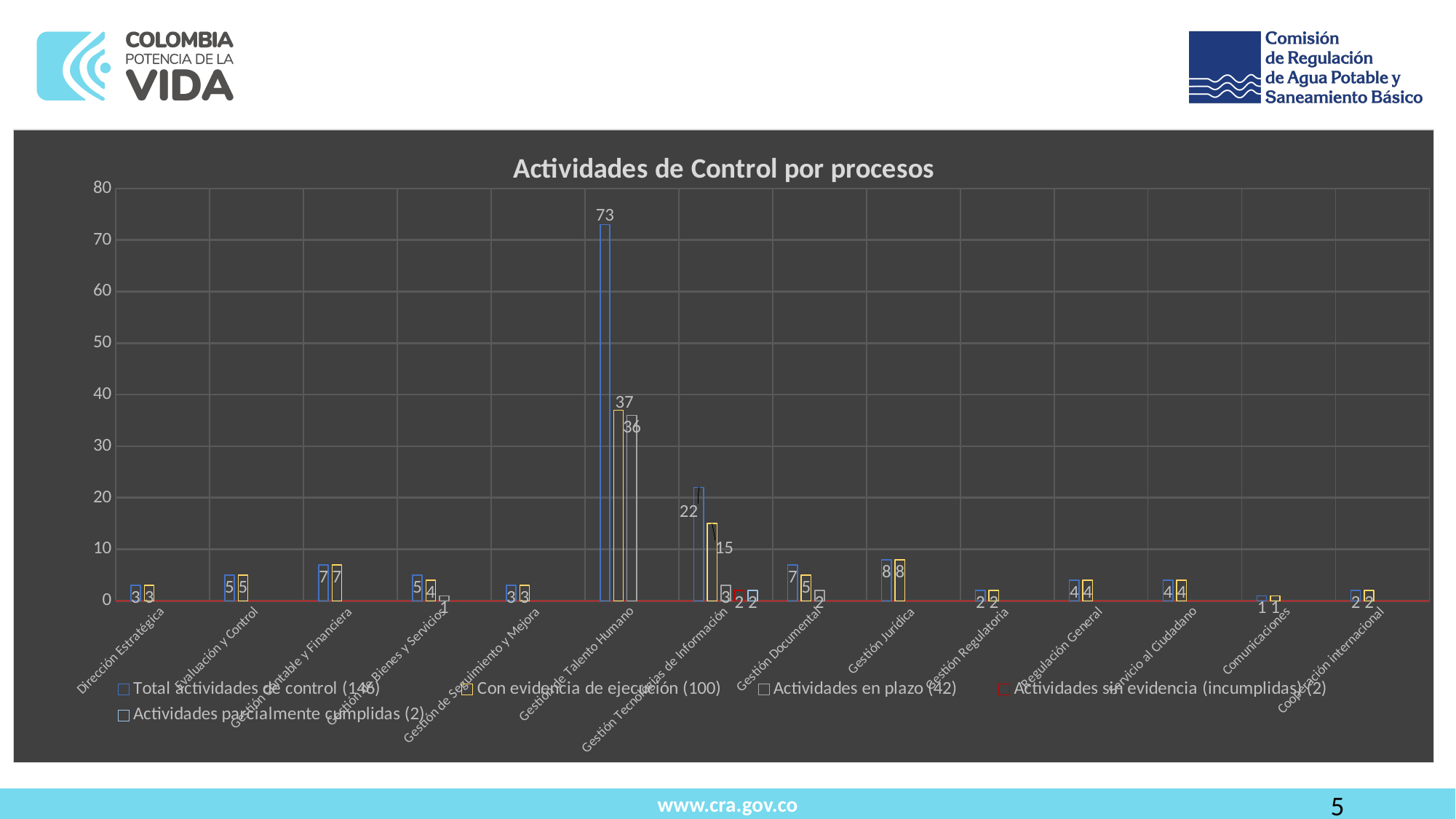
What is the Actividades en plazo value for Gestión de Talento Humano? 36 Which process has the highest value for Total actividades de control? Gestión de Talento Humano How many series does the legend list? 5 How many process categories are shown on the x axis? 14 What is the title of the chart? Actividades de Control por procesos What is the Total actividades de control value for Gestión Tecnologías de Información? 22 What is the Total actividades de control value for Gestión de Talento Humano? 73 What is the difference between the Total actividades de control values for Gestión de Talento Humano and Gestión Tecnologías de Información? 51 What kind of chart is shown on the slide? bar chart Is the Total actividades de control value for Gestión de Talento Humano greater or less than 70? greater What is the Con evidencia de ejecución value for Gestión de Talento Humano? 37 What is the Con evidencia de ejecución value for Gestión Tecnologías de Información? 15